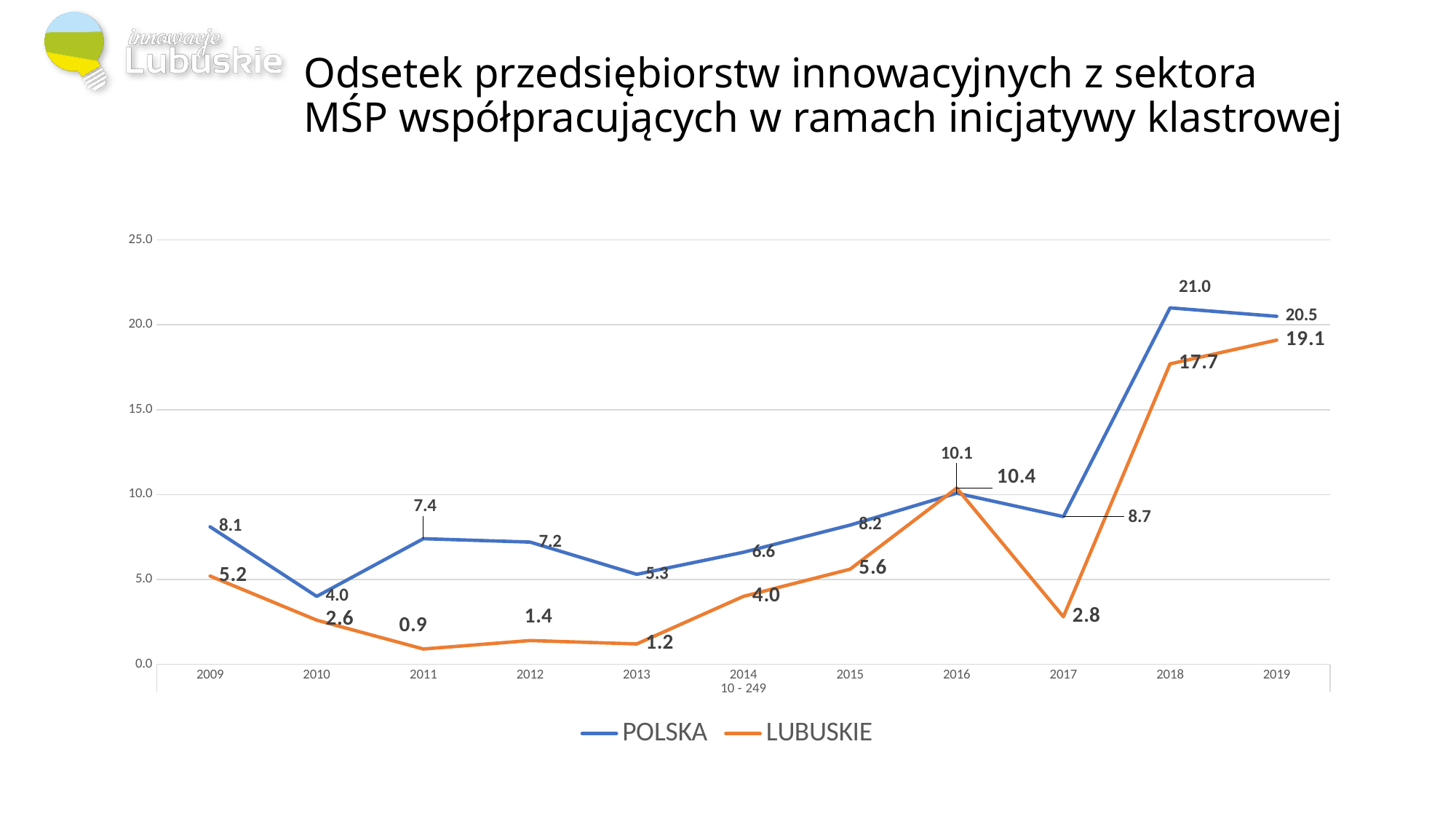
In which year is the POLSKA value lowest? 2010 Does the LUBUSKIE value rise or fall from 2017 to 2018? rise In which year is the LUBUSKIE value highest? 2019 What is the value for POLSKA in 2018? 21.0 How many years are shown on the x axis? 11 What is the value for LUBUSKIE in 2017? 2.8 How many series does the legend list? 2 Which colour is used for the POLSKA line? blue What is the difference between the POLSKA and LUBUSKIE values in 2019? 1.4 What is the value for LUBUSKIE in 2011? 0.9 Which series has the larger value in 2016, POLSKA or LUBUSKIE? LUBUSKIE What type of chart is shown on the slide? line chart